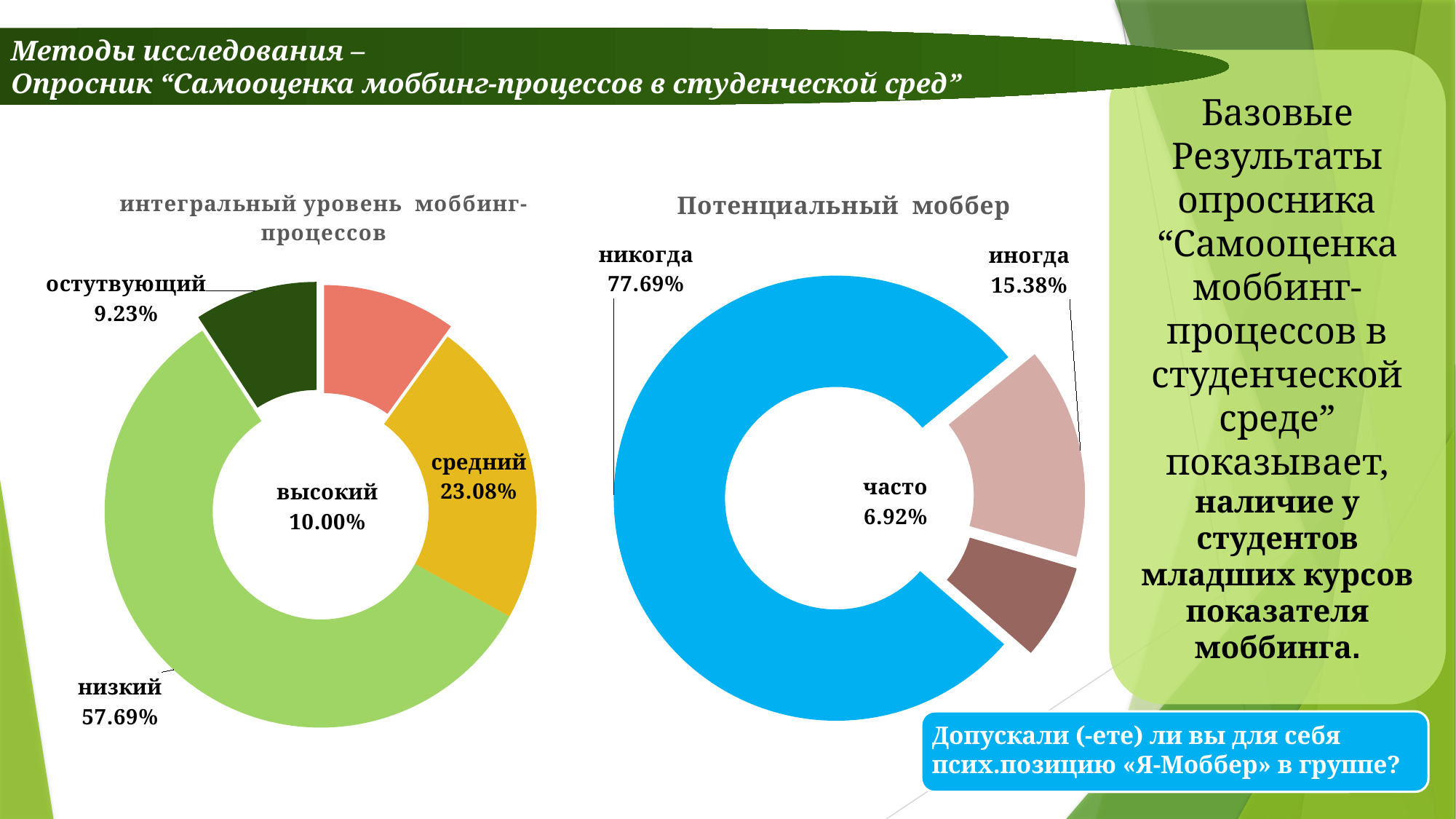
In the chart titled "интегральный уровень моббинг-процессов", which category has the largest share? низкий In the chart titled "интегральный уровень моббинг-процессов", how many categories are shown? 4 In the chart titled "Потенциальный моббер", which is larger, "иногда" or "часто"? иногда In the chart titled "Потенциальный моббер", what is the value for "часто"? 6.92% In the chart titled "Потенциальный моббер", what is the difference between "никогда" and "иногда"? 62.31% In the chart titled "интегральный уровень моббинг-процессов", which category has the smallest share? остутвующий In the chart titled "интегральный уровень моббинг-процессов", what is the value for "низкий"? 57.69% In the chart titled "интегральный уровень моббинг-процессов", what is the difference between "средний" and "высокий"? 13.08% In the chart titled "интегральный уровень моббинг-процессов", what is the value for "средний"? 23.08% In the chart titled "Потенциальный моббер", what colour is the "никогда" slice? Blue In the chart titled "Потенциальный моббер", what is the value for "никогда"? 77.69% What kind of chart is the chart titled "Потенциальный моббер"? Doughnut chart